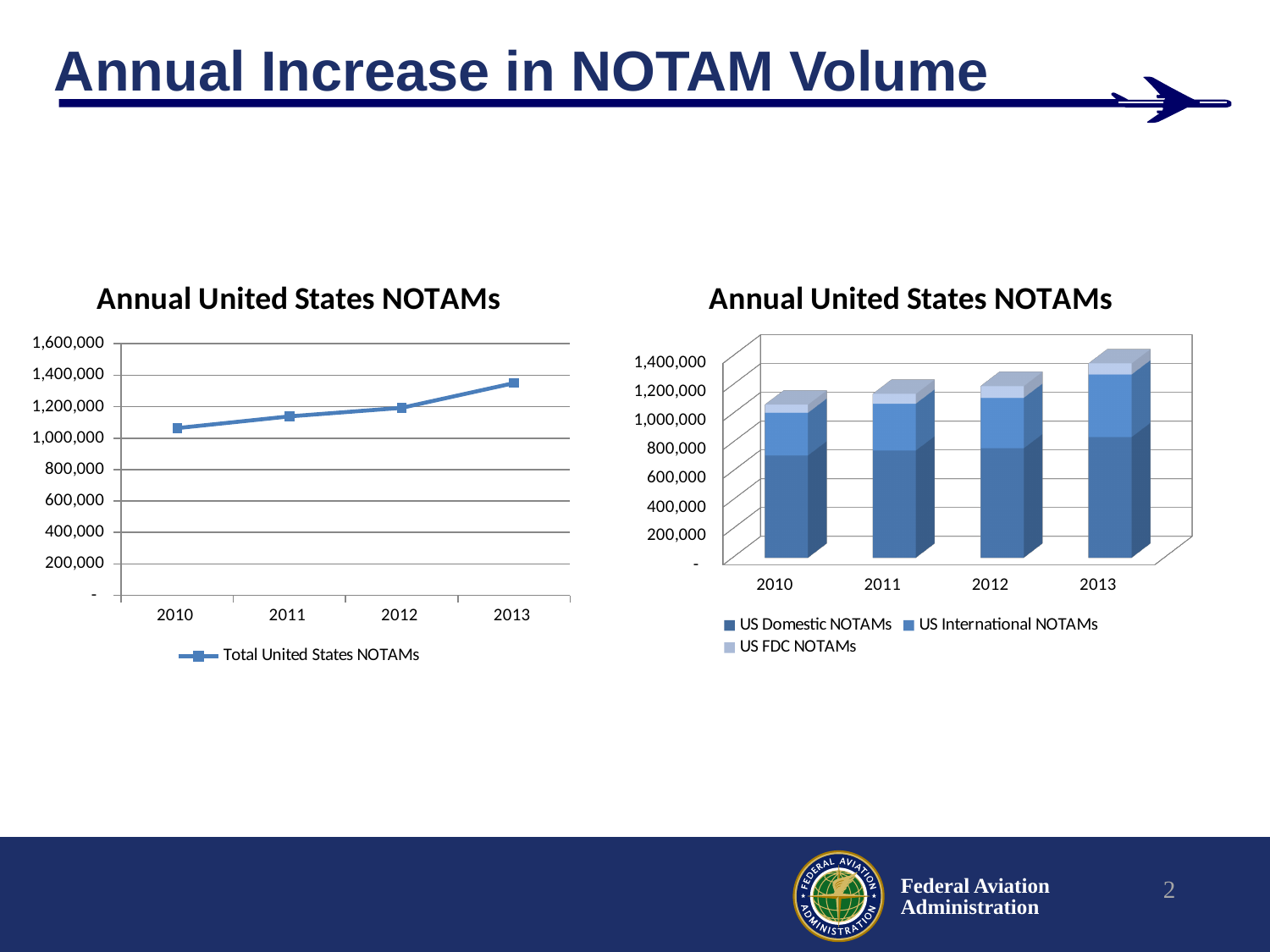
In the right chart, which year has the tallest stacked bar? 2013 In the left chart, do the Total United States NOTAMs values rise or fall from 2010 to 2013? rise What kind of chart is the chart on the right side of the slide? bar chart In the left chart, is the Total United States NOTAMs value for 2013 greater or less than 1,400,000? less In the left chart, is the Total United States NOTAMs value for 2010 greater or less than 1,000,000? greater What kind of chart is the chart on the left side of the slide? line chart How many series does the legend of the right chart list? 3 In the right chart, is the US Domestic NOTAMs value for 2010 greater or less than 800,000? less In the left chart, which year has the lowest Total United States NOTAMs value? 2010 In the left chart, which year has the highest Total United States NOTAMs value? 2013 How many years are plotted in the left chart? 4 What is the title of the chart on the right side of the slide? Annual United States NOTAMs